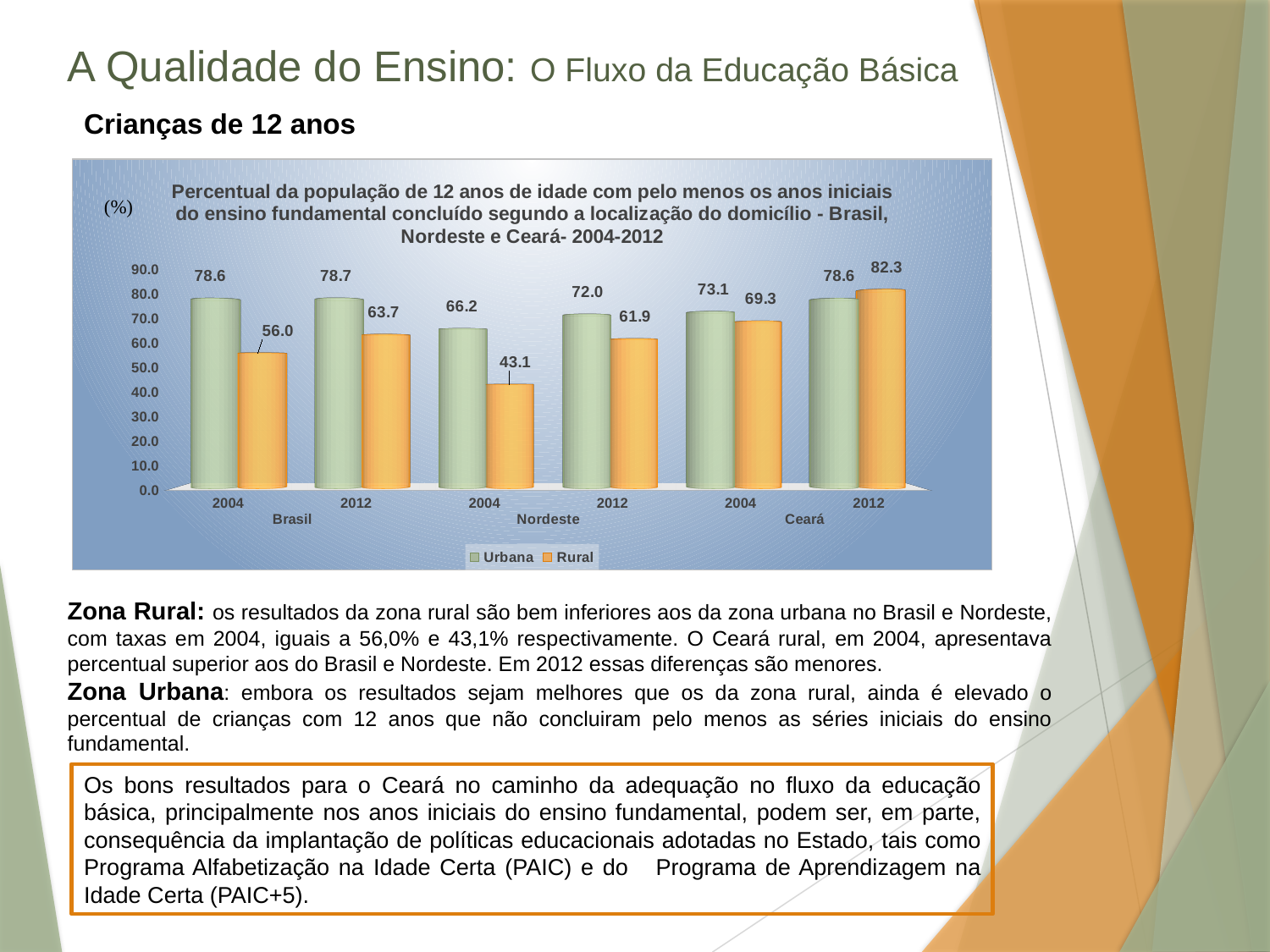
What is the Urbana value for Brasil in 2004? 78.6 Does the Rural value for Nordeste rise or fall from 2004 to 2012? Rise What is the Urbana value for Nordeste in 2012? 72.0 How many series does the legend list? 2 What is the Rural value for Ceará in 2012? 82.3 What is the difference between the Urbana and Rural values for Brasil in 2004? 22.6 Which is larger for Ceará in 2012, the Urbana value or the Rural value? Rural Which category has the highest Rural value? Ceará 2012 What is the Rural value for Nordeste in 2004? 43.1 Which colour represents the Rural series in the chart? Orange Which category has the lowest Rural value? Nordeste 2004 What kind of chart is shown on the slide? Bar chart